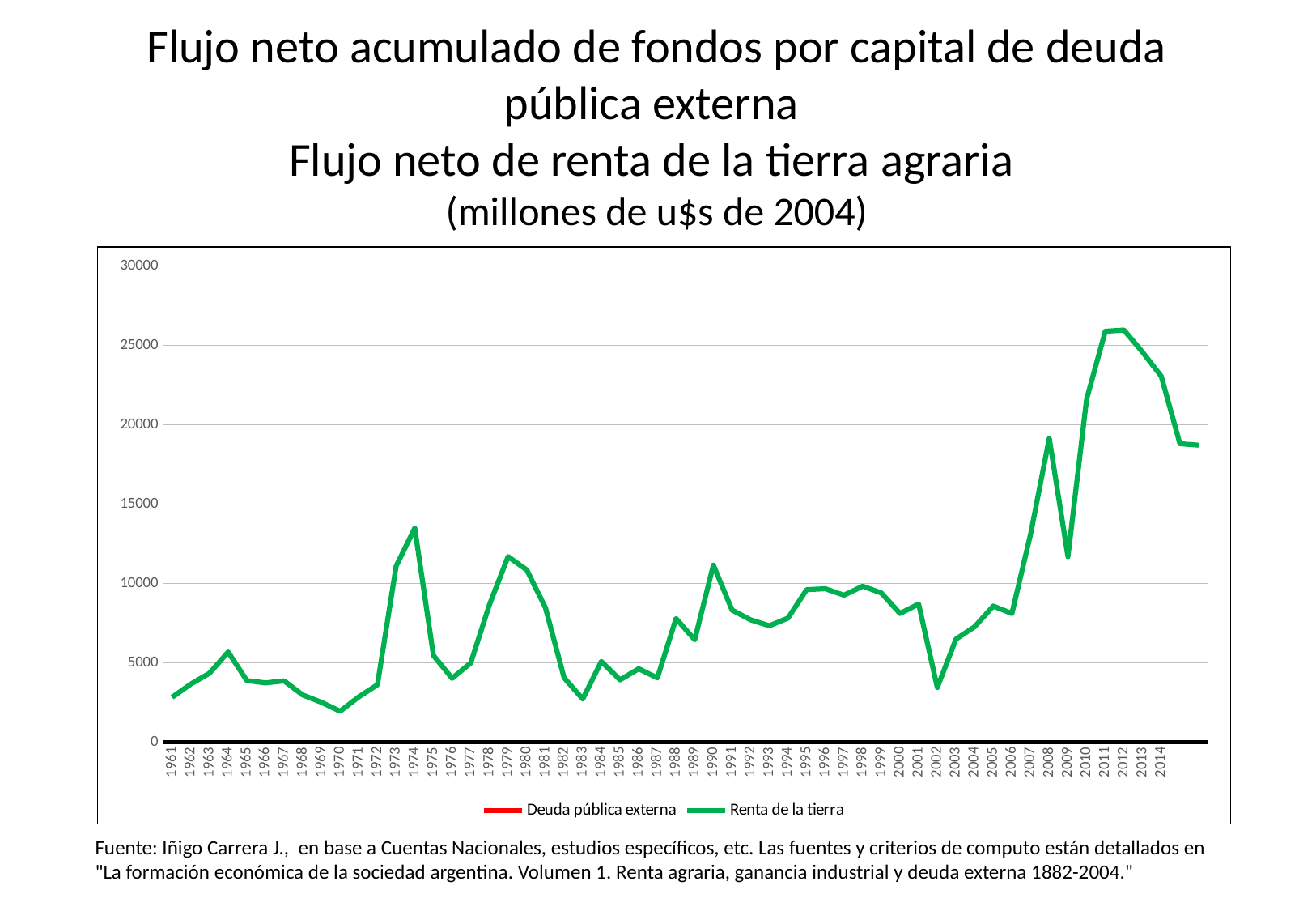
Is the Renta de la tierra value for 1983 greater or less than 5000? less In which year is the Renta de la tierra value lowest? 1970 Does the Renta de la tierra line rise or fall between 2002 and 2011? rise What kind of chart is shown on the slide? line chart How many series does the legend list? 2 Which year has the higher Renta de la tierra value, 2008 or 2009? 2008 Is the Renta de la tierra value for 2002 greater or less than 5000? less Is the Renta de la tierra value for 1974 greater or less than 10000? greater Which series is drawn in green? Renta de la tierra Which year has the higher Renta de la tierra value, 1974 or 1979? 1974